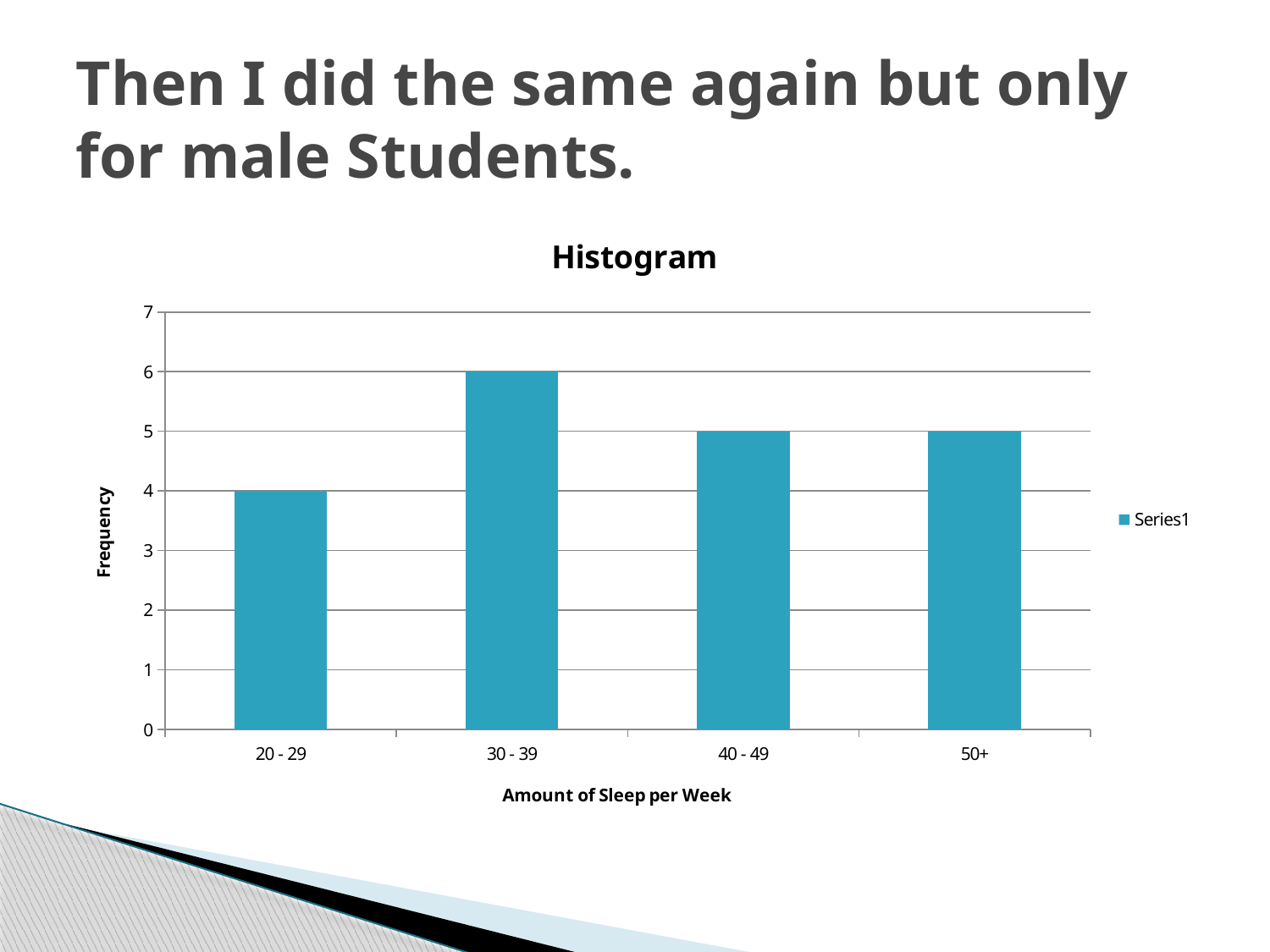
What is the frequency for the 30 - 39 category? 6 How many categories are shown on the x axis? 4 Which category has the lowest frequency? 20 - 29 What is the difference in frequency between the 30 - 39 and 20 - 29 categories? 2 What is the frequency for the 20 - 29 category? 4 What is the frequency for the 40 - 49 category? 5 Which has a higher frequency, 20 - 29 or 40 - 49? 40 - 49 How many series does the legend list? 1 What is the title of the chart? Histogram What kind of chart is shown on the slide? bar chart What is the frequency for the 50+ category? 5 Which category has the highest frequency? 30 - 39